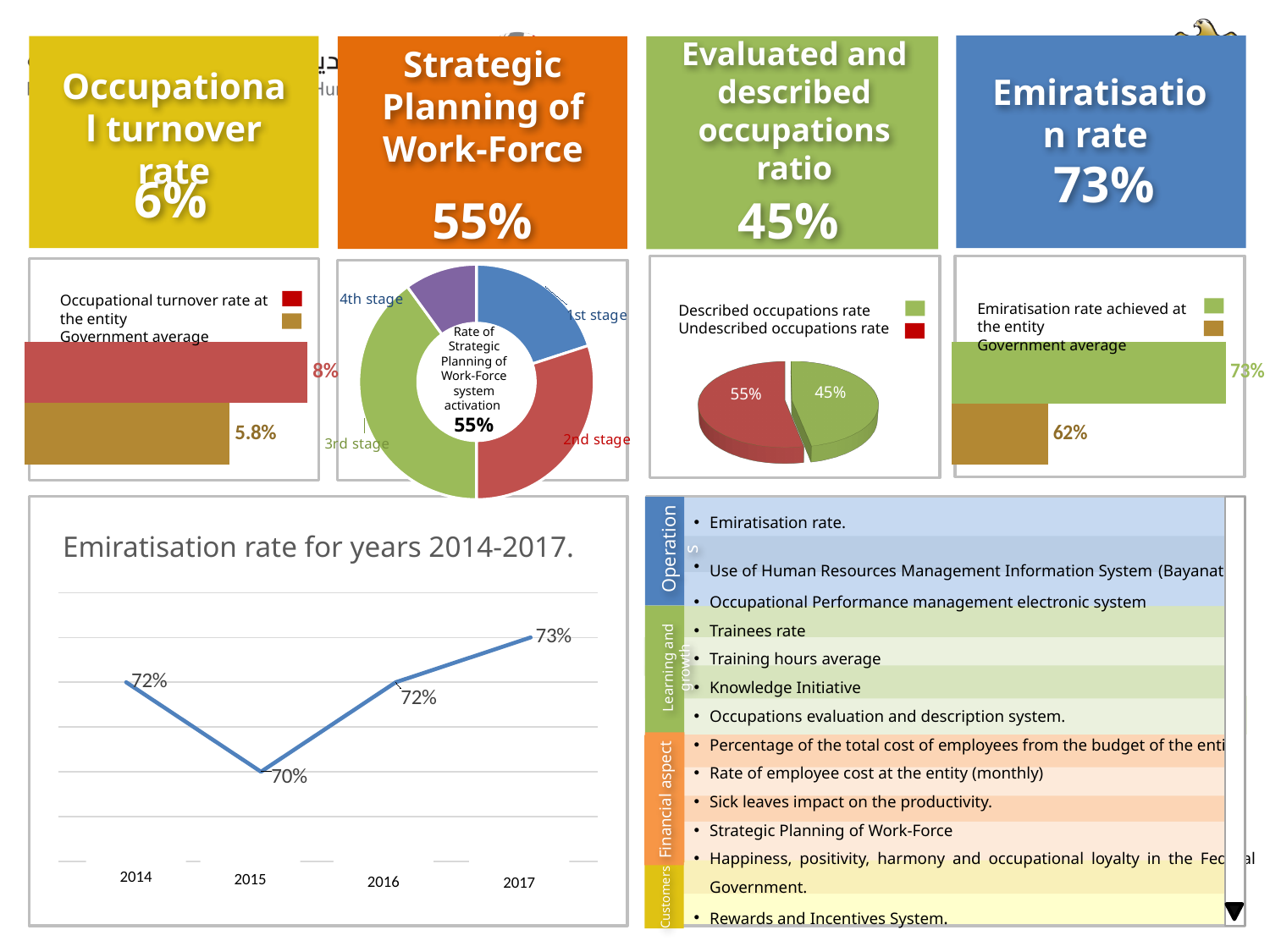
In the Occupational turnover rate chart, what is the Government average? 5.8% In the Evaluated and described occupations pie chart, what is the undescribed occupations rate? 55% What type of chart is used for the Strategic Planning of Work-Force system activation? Donut chart In the Occupational turnover rate chart, which is larger: the rate at the entity or the Government average? The rate at the entity In the Occupational turnover rate chart, what is the occupational turnover rate at the entity? 8% In the line chart 'Emiratisation rate for years 2014-2017', which year has the highest Emiratisation rate? 2017 In the line chart 'Emiratisation rate for years 2014-2017', what was the Emiratisation rate in 2015? 70% In the line chart 'Emiratisation rate for years 2014-2017', how many years are plotted? 4 In the Evaluated and described occupations pie chart, what is the described occupations rate? 45% In the Emiratisation rate chart, what is the Emiratisation rate achieved at the entity? 73% How many stages are shown in the Strategic Planning of Work-Force donut chart? 4 In the Emiratisation rate chart, what is the difference between the rate achieved at the entity and the Government average? 11%